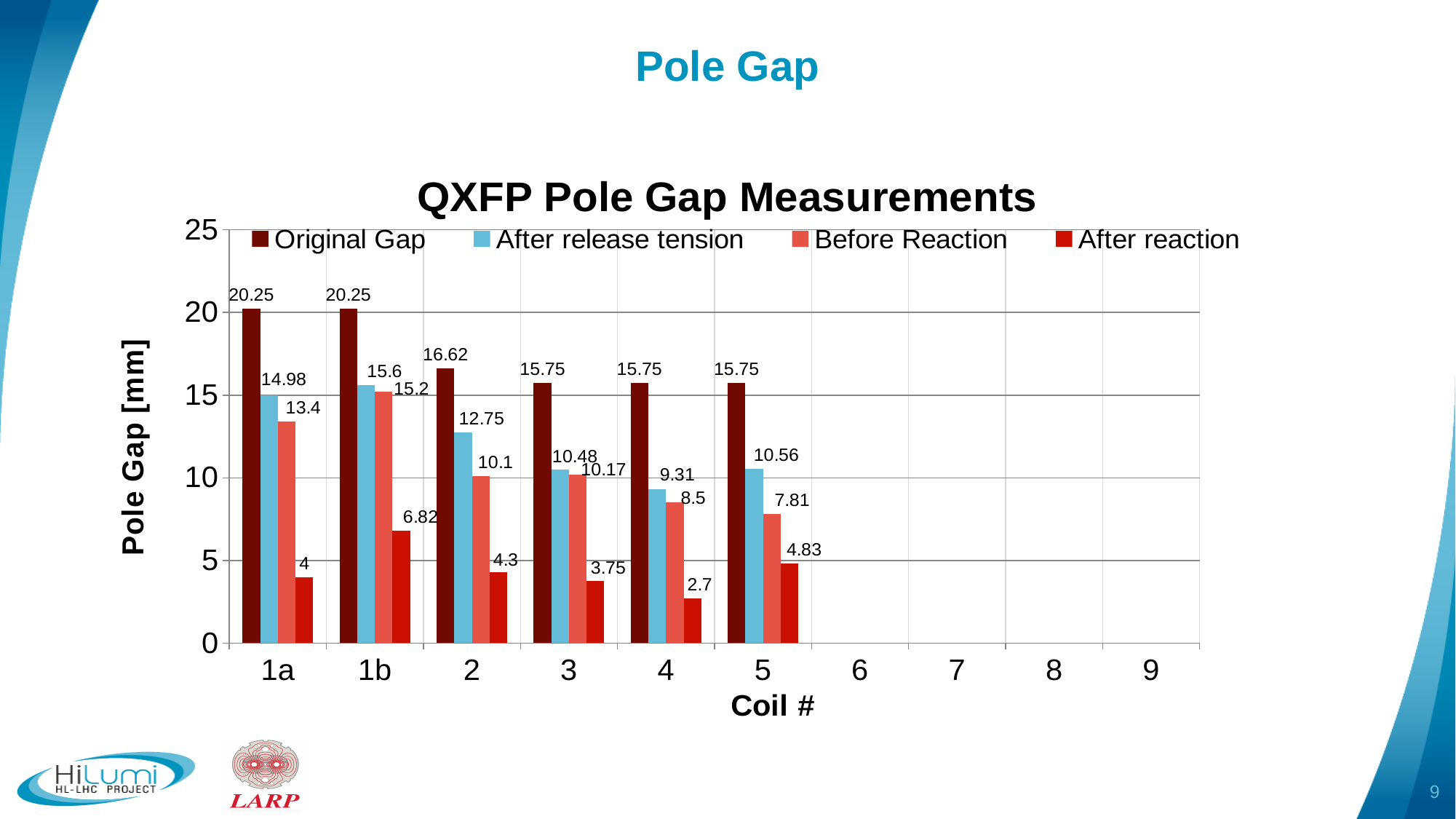
Which coil has the highest After release tension value? 1b What is the difference between the Original Gap and the After reaction value for coil 1a? 16.25 How many series does the legend list? 4 What kind of chart is shown on the slide? bar chart What is the Original Gap value for coil 2? 16.62 Which coil has the larger Before Reaction value, 1a or 1b? 1b What is the title of the y axis? Pole Gap [mm] What is the Before Reaction value for coil 5? 7.81 Is the After release tension value for coil 4 greater or less than 10? less How many coils have plotted data in the chart? 6 What is the After reaction pole gap for coil 1b? 6.82 Which coil has the lowest After reaction value? 4